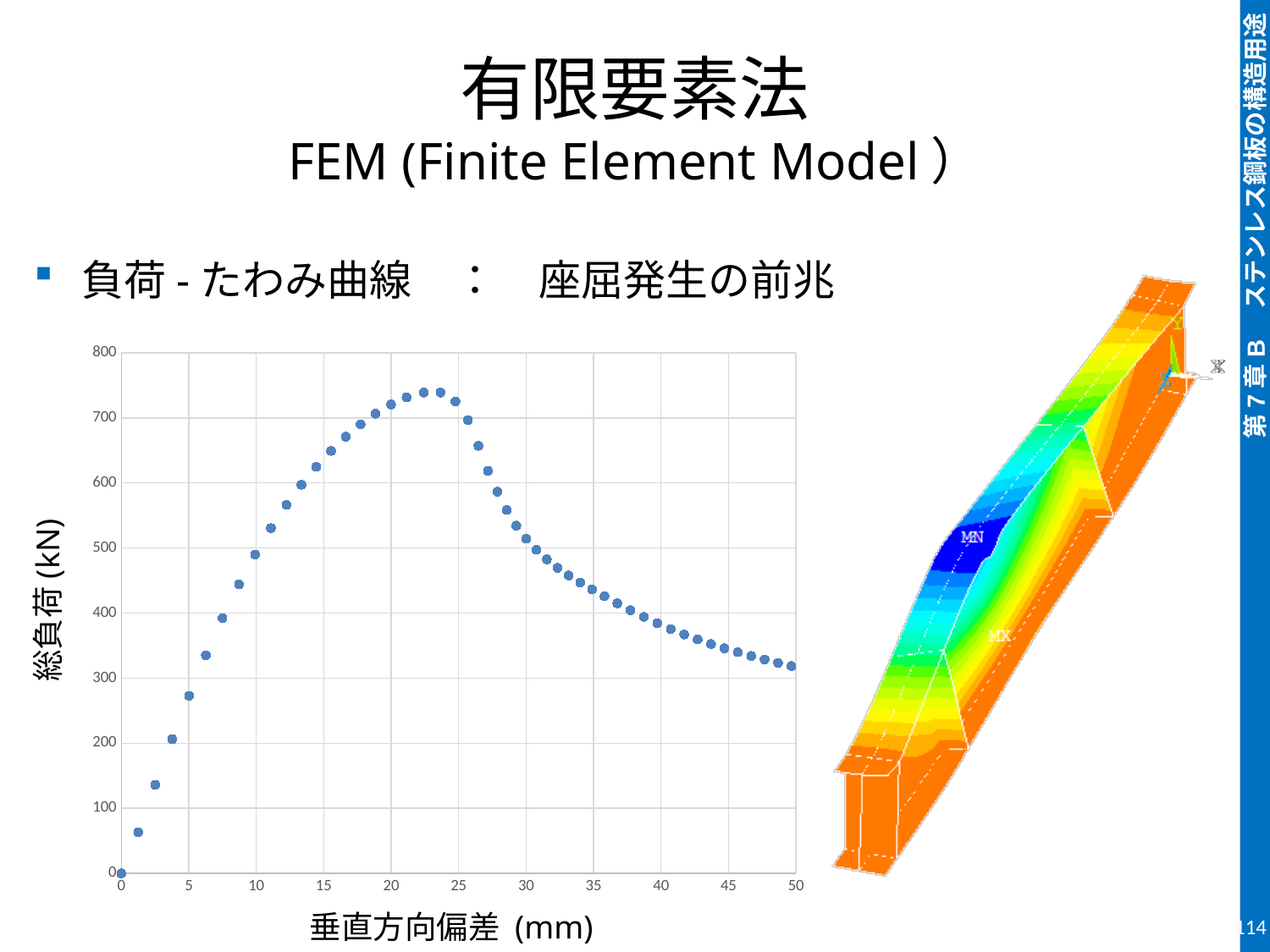
Between which two x-axis ticks does the peak 総負荷 occur? between 20 and 25 mm Do the values of 総負荷 rise or fall as 垂直方向偏差 increases from 0 mm to 20 mm? rise Which has the larger 総負荷: the point at 10 mm or the point at 40 mm of 垂直方向偏差? 10 mm Is the value of 総負荷 at a 垂直方向偏差 of 40 mm greater or less than 400? less Is the value of 総負荷 at a 垂直方向偏差 of 20 mm greater or less than 700? greater Do the values of 総負荷 rise or fall as 垂直方向偏差 increases from 25 mm to 50 mm? fall What kind of chart is shown on the left of the slide? scatter chart Is the value of 総負荷 at a 垂直方向偏差 of 5 mm greater or less than 300? less What is the label of the vertical axis of the chart? 総負荷 (kN) What is the label of the horizontal axis of the chart? 垂直方向偏差 (mm)